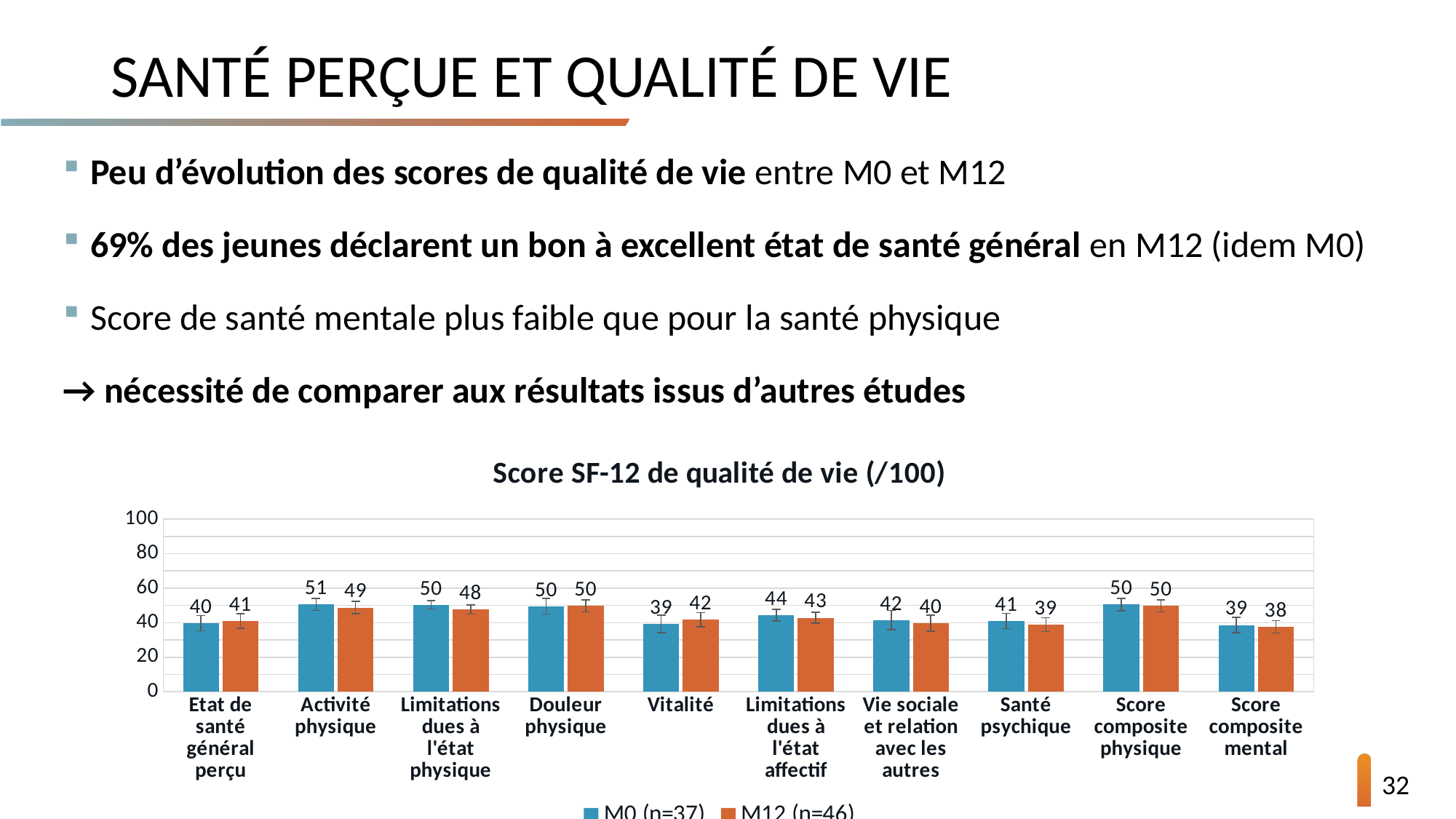
How many series does the chart's legend list? 2 How many categories are shown on the x axis of the chart? 10 Is the M0 value for Score composite physique greater or less than 40? greater What is the M12 (n=46) value for Santé psychique? 39 Which category has the lowest M12 (n=46) value? Score composite mental What is the difference between the M0 and M12 values for Vitalité? 3 What is the M0 (n=37) value for Vitalité? 39 For Vie sociale et relation avec les autres, which is larger: the M0 value or the M12 value? M0 What type of chart is shown on the slide? Bar chart What is the M12 (n=46) value for Activité physique? 49 Which category has the highest M0 (n=37) value? Activité physique What is the difference between the M0 and M12 values for Limitations dues à l'état physique? 2